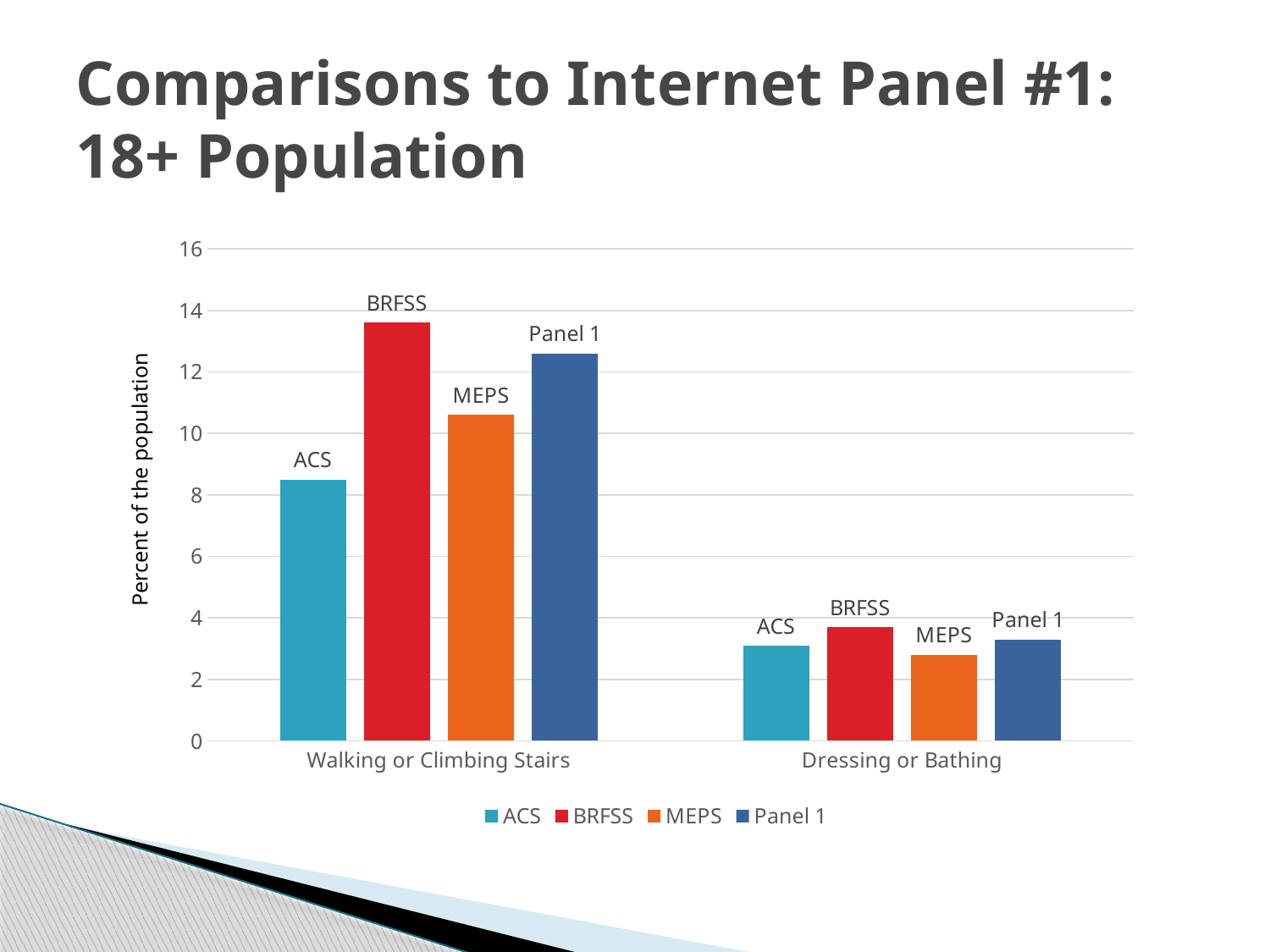
For Walking or Climbing Stairs, which is larger: Panel 1 or MEPS? Panel 1 What kind of chart is shown on the slide? Bar chart Which series has the highest value for Dressing or Bathing? BRFSS Is the value for MEPS in Dressing or Bathing greater or less than 4? less Which series has the lowest value for Dressing or Bathing? MEPS Which series has the lowest value for Walking or Climbing Stairs? ACS Which series has the highest value for Walking or Climbing Stairs? BRFSS What is the label on the vertical axis? Percent of the population Is the value for ACS in Walking or Climbing Stairs greater or less than 8? greater How many series does the legend list? 4 How many categories are shown on the x axis? 2 Is the value for Panel 1 in Walking or Climbing Stairs greater or less than 12? greater